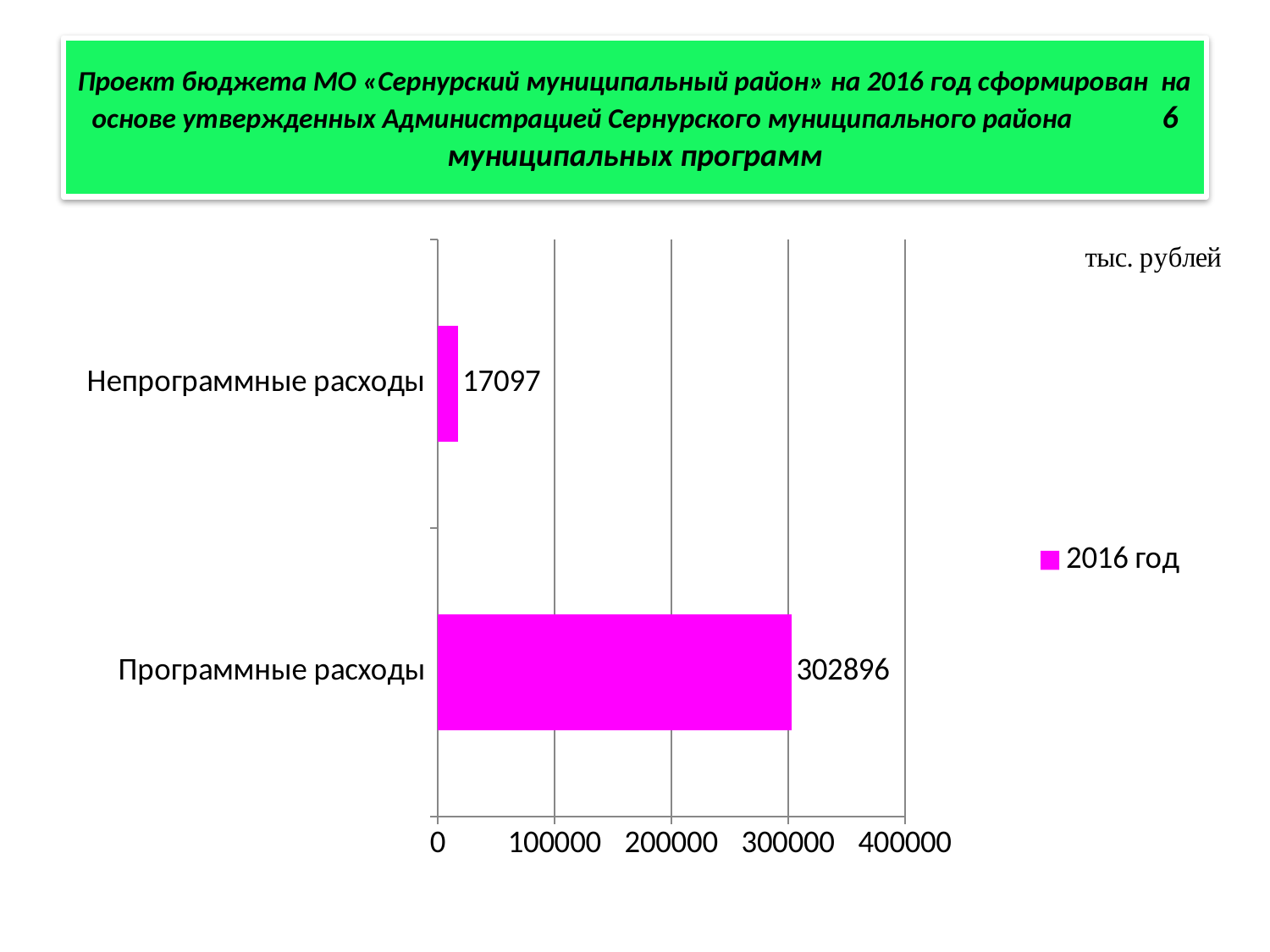
Is the value for Непрограммные расходы greater or less than 100000? less What is the value for Программные расходы? 302896 What series name is shown in the legend? 2016 год Which category has the highest value? Программные расходы Is the value for Программные расходы greater or less than 300000? greater What kind of chart is shown? bar chart What is the value for Непрограммные расходы? 17097 How many series does the legend list? 1 Which category has the lowest value? Непрограммные расходы What is the difference between Программные расходы and Непрограммные расходы? 285799 Which is larger, Программные расходы or Непрограммные расходы? Программные расходы How many categories are shown in the chart? 2